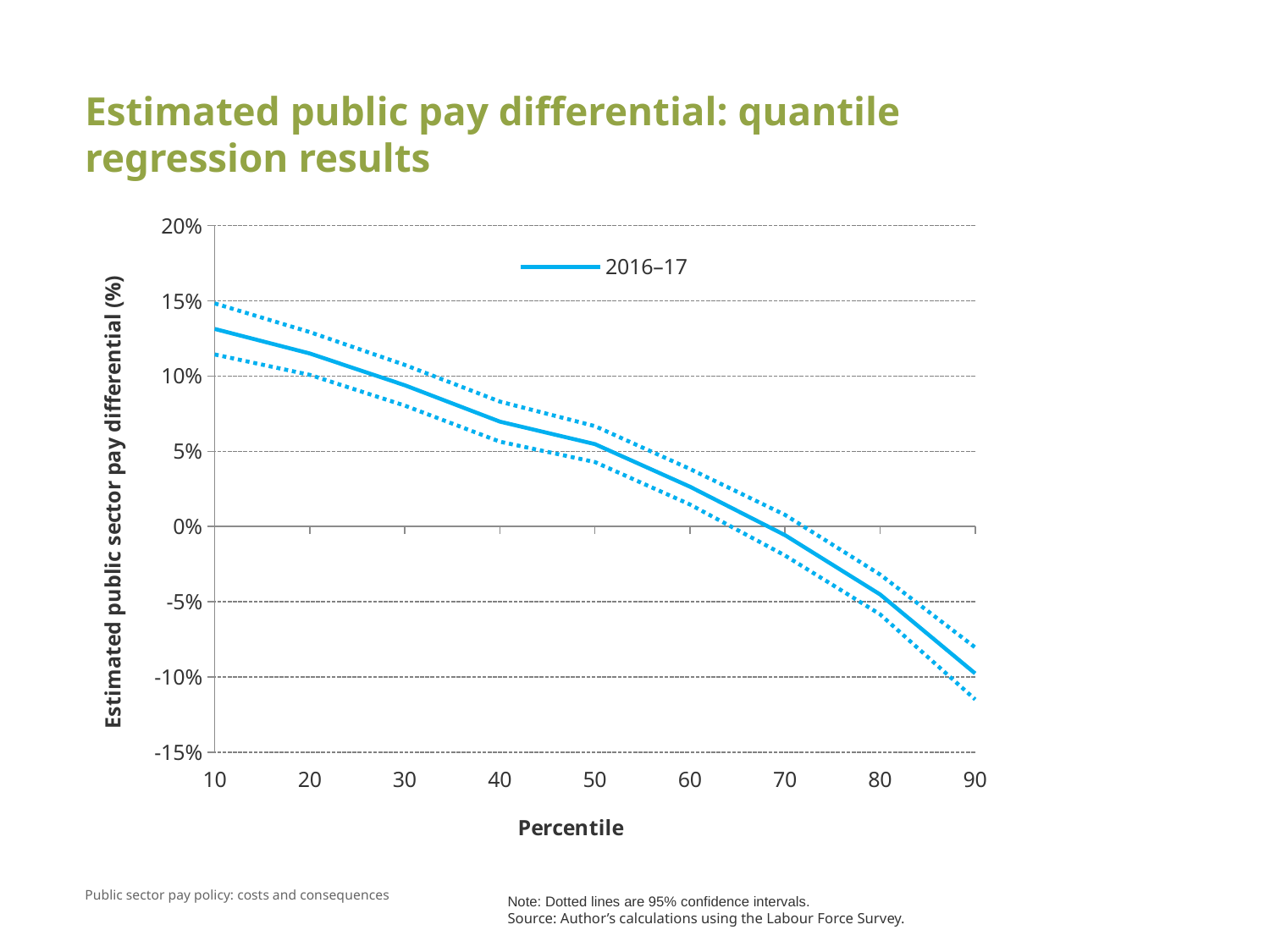
Is the 2016–17 pay differential at the 90th percentile greater or less than -5%? less Does the estimated public sector pay differential rise or fall as the percentile increases from 10 to 90? fall Is the 2016–17 pay differential at the 40th percentile greater or less than 5%? greater How many percentile values are labelled on the x axis? 9 At which percentile is the estimated public sector pay differential highest? 10 Is the 2016–17 pay differential at the 10th percentile greater or less than 10%? greater What kind of chart is shown on the slide? line chart Which percentile has the larger estimated pay differential, 20 or 70? 20 At which percentile is the estimated public sector pay differential lowest? 90 What is the name of the series shown in the legend? 2016–17 How many series does the legend list? 1